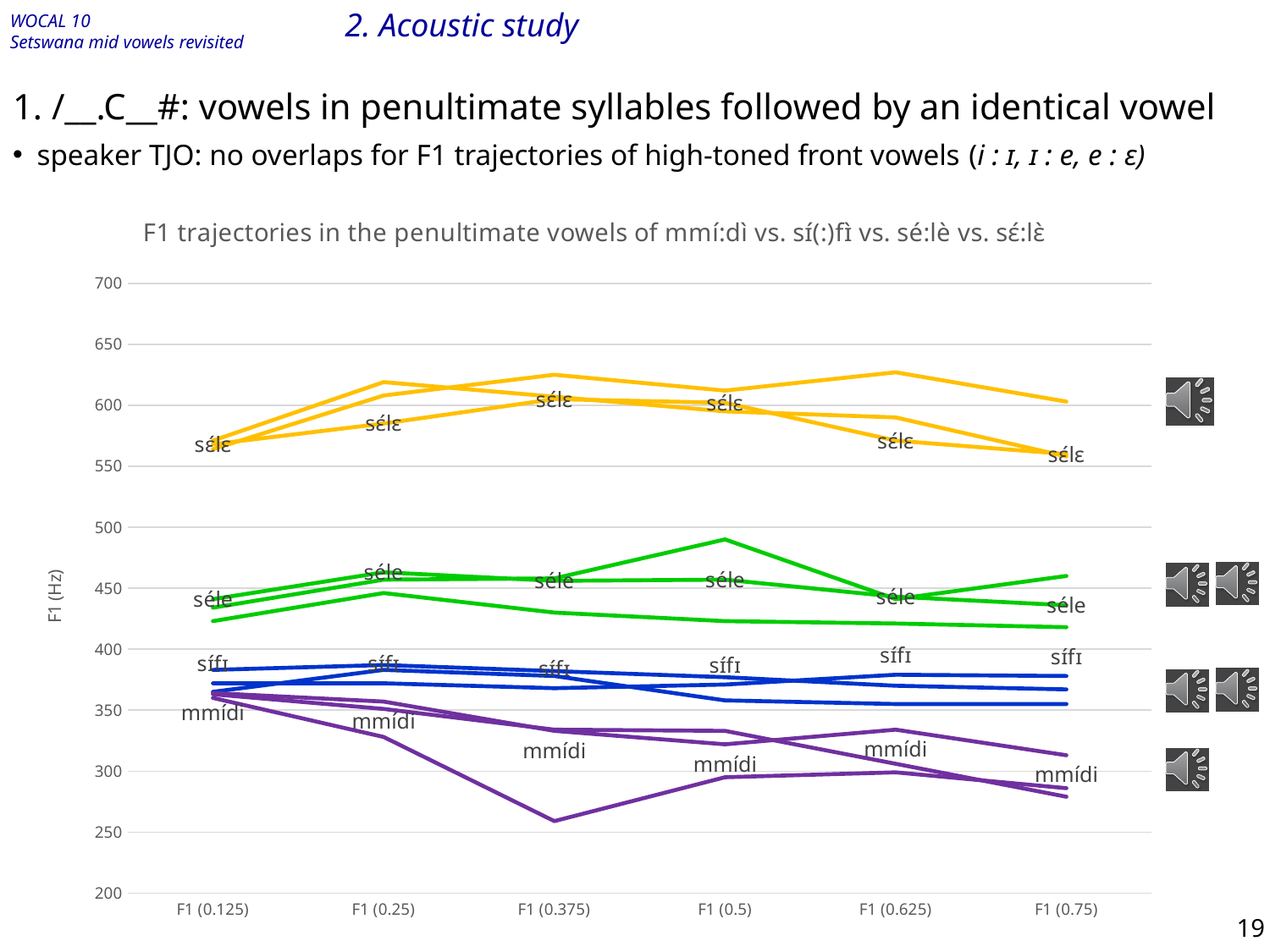
Are the F1 values for sífɪ at F1 (0.125) greater or less than 400 Hz? less Are the F1 values for séle at F1 (0.5) greater or less than 400 Hz? greater What is the label of the y axis? F1 (Hz) Do the F1 trajectories for mmídi rise or fall from F1 (0.125) to F1 (0.75)? fall Are the F1 values for mmídi at F1 (0.375) greater or less than 350 Hz? less Which word has the highest F1 trajectories in the chart? sɛ́lɛ What is the title of the chart? F1 trajectories in the penultimate vowels of mmí:dì vs. sí(:)fì vs. sé:lè vs. sɛ́:lɛ̀ How many time points are shown along the x axis? 6 What kind of chart is shown on the slide? line chart Which word has the lowest F1 trajectories in the chart? mmídi Which has higher F1 values, séle or sífɪ? séle